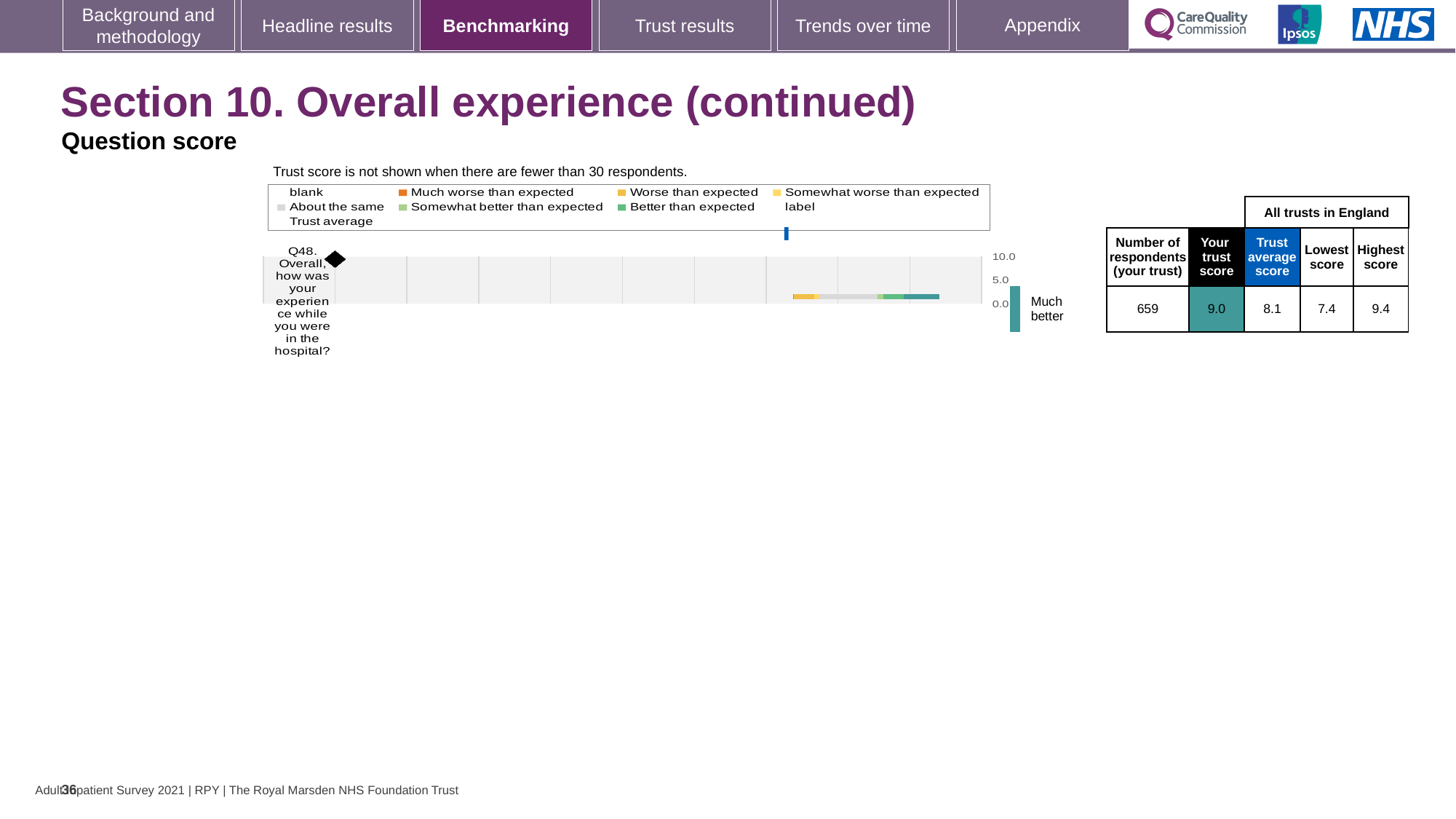
According to the table next to the chart, what is the highest score among all trusts in England for Q48? 9.4 For Q48, which is larger: the trust's own score or the trust average score? Your trust score According to the table next to the chart, what is the trust average score for Q48? 8.1 How many survey questions are plotted in the chart? 1 What is the maximum value shown on the chart's score axis? 10.0 What is the difference between the highest score and the lowest score for Q48 shown in the table? 2.0 According to the table next to the chart, what is the trust's score for Q48? 9.0 According to the table next to the chart, how many respondents from the trust answered Q48? 659 How many entries does the chart legend list? 9 According to the table next to the chart, what is the lowest score among all trusts in England for Q48? 7.4 What kind of chart is shown on the slide? bar chart Which question number is plotted in the chart? Q48